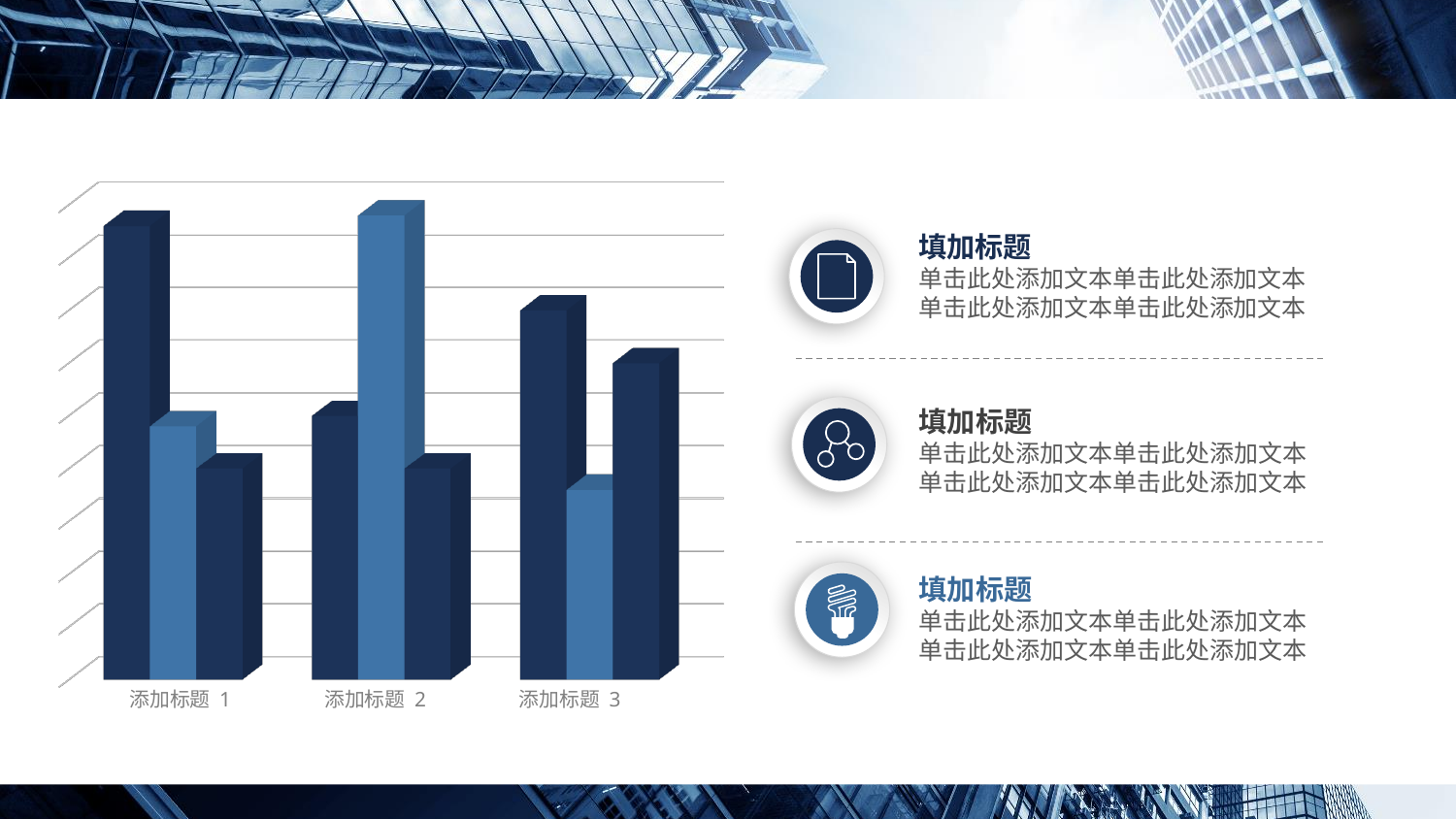
Within the category 添加标题 3, which bar is the shortest? the middle bar What kind of chart is shown on the left of the slide? bar chart How many bars are plotted for each category in the bar chart? 3 Are numeric data labels printed on the bars of the chart? No Does the bar chart display a legend? No Which category contains the tallest bar in the whole chart? 添加标题 2 How many categories are shown on the x axis of the bar chart? 3 Is the middle bar taller for 添加标题 1 or for 添加标题 3? 添加标题 1 Is the first (leftmost) bar taller for 添加标题 1 or for 添加标题 2? 添加标题 1 Within the category 添加标题 2, which bar is the tallest? the middle bar Within the category 添加标题 1, which bar is the tallest? the first (leftmost) bar Is the third (rightmost) bar taller for 添加标题 1 or for 添加标题 3? 添加标题 3